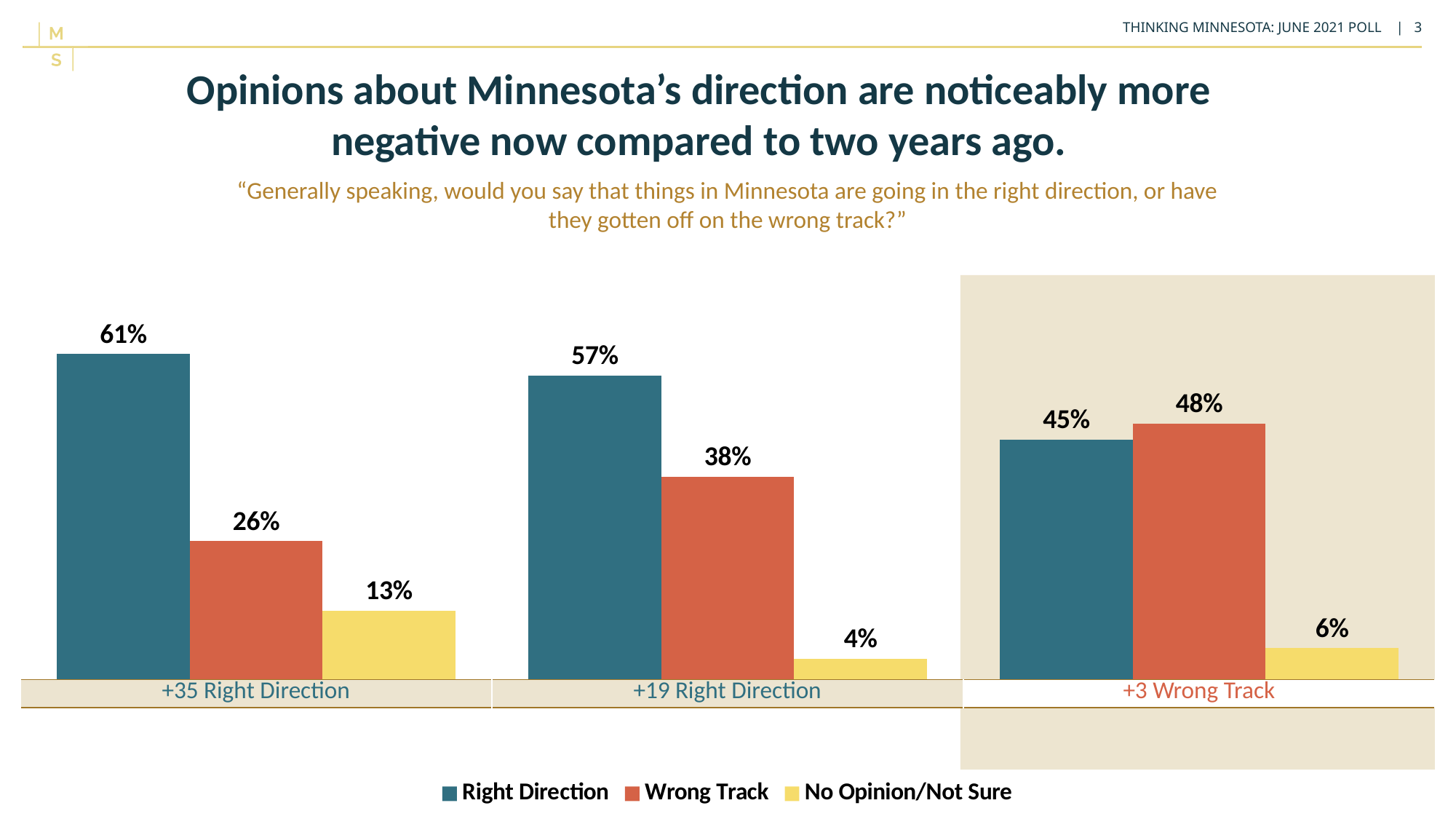
How do the Right Direction values change across the three groups from left to right? They fall What kind of chart is shown on the slide? bar chart What is the Right Direction value in the leftmost group (+35 Right Direction)? 61% What is the Wrong Track value in the middle group (+19 Right Direction)? 38% What is the No Opinion/Not Sure value in the rightmost group (+3 Wrong Track)? 6% In the rightmost group (+3 Wrong Track), which is larger: Right Direction or Wrong Track? Wrong Track How many series does the legend list? 3 What colour represents the Wrong Track series in the legend? Red/orange How many groups of bars are plotted on the chart? 3 Which group has the highest Wrong Track value? +3 Wrong Track Which group has the lowest No Opinion/Not Sure value? +19 Right Direction What is the difference between the Right Direction and Wrong Track values in the leftmost group (+35 Right Direction)? 35%